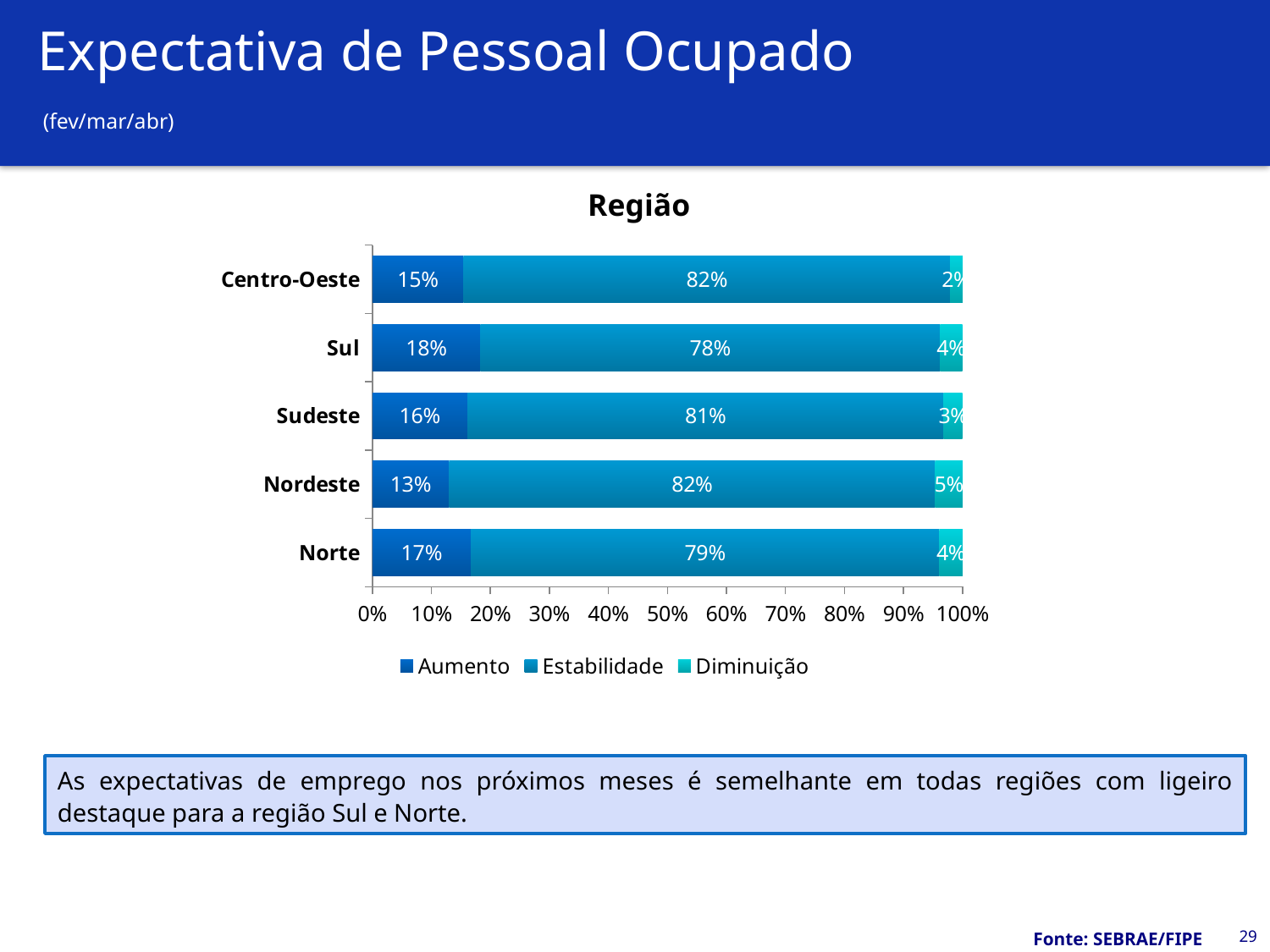
Which region has the lowest Diminuição value? Centro-Oeste How many regions are shown in the chart? 5 Which region has the highest Aumento value? Sul What is the difference between the Estabilidade values for Centro-Oeste and Sul? 4 percentage points How many series does the legend list? 3 What is the Estabilidade value for Norte? 79% Which has a larger Aumento value, Norte or Sudeste? Norte What is the Diminuição value for Nordeste? 5% What is the Aumento value for Sul? 18% What kind of chart is shown on the slide? Stacked bar chart Which region has the lowest Aumento value? Nordeste What is the title of the chart? Região